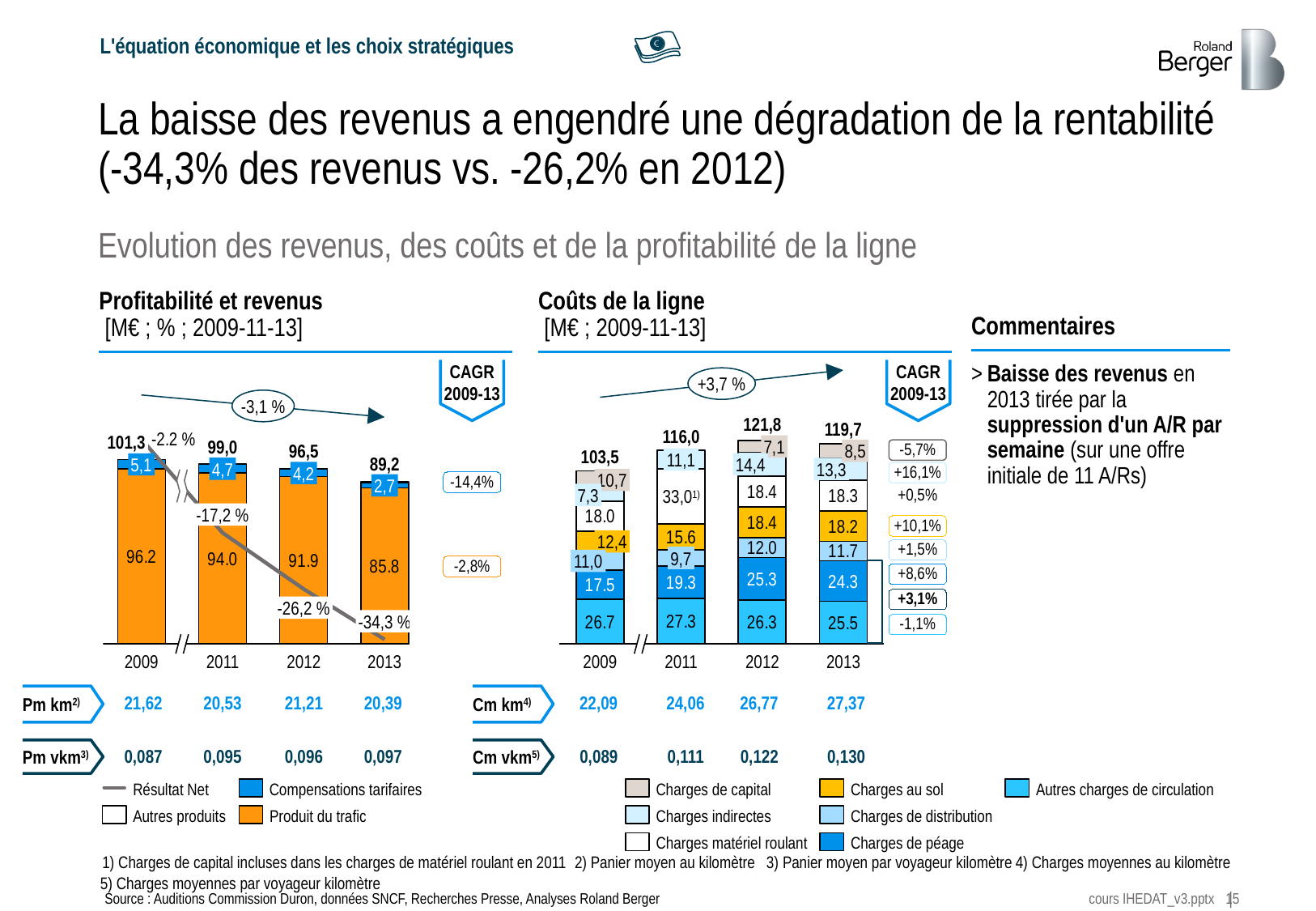
How many series does the legend of the 'Coûts de la ligne' chart list? 7 In the 'Profitabilité et revenus' chart, what is the Résultat Net percentage shown for 2013? -34,3 % In the 'Profitabilité et revenus' chart, what is the total value shown above the bar for 2013? 89,2 In the 'Coûts de la ligne' chart, what is the value of Charges de péage for 2013? 25.5 In the 'Coûts de la ligne' chart, which year has the highest total? 2012 In the 'Profitabilité et revenus' chart, what is the value of Produit du trafic for 2012? 91.9 In the 'Coûts de la ligne' chart, what is the total value shown above the bar for 2012? 121,8 In the 'Profitabilité et revenus' chart, do the bar totals rise or fall from 2009 to 2013? fall What kind of chart is the 'Coûts de la ligne' chart? stacked bar chart In the 'Profitabilité et revenus' chart, which year has the highest total? 2009 In the 'Profitabilité et revenus' chart, what is the difference between the 2009 total and the 2013 total? 12,1 In the 'Coûts de la ligne' chart, is Charges au sol larger in 2011 or in 2012? 2012